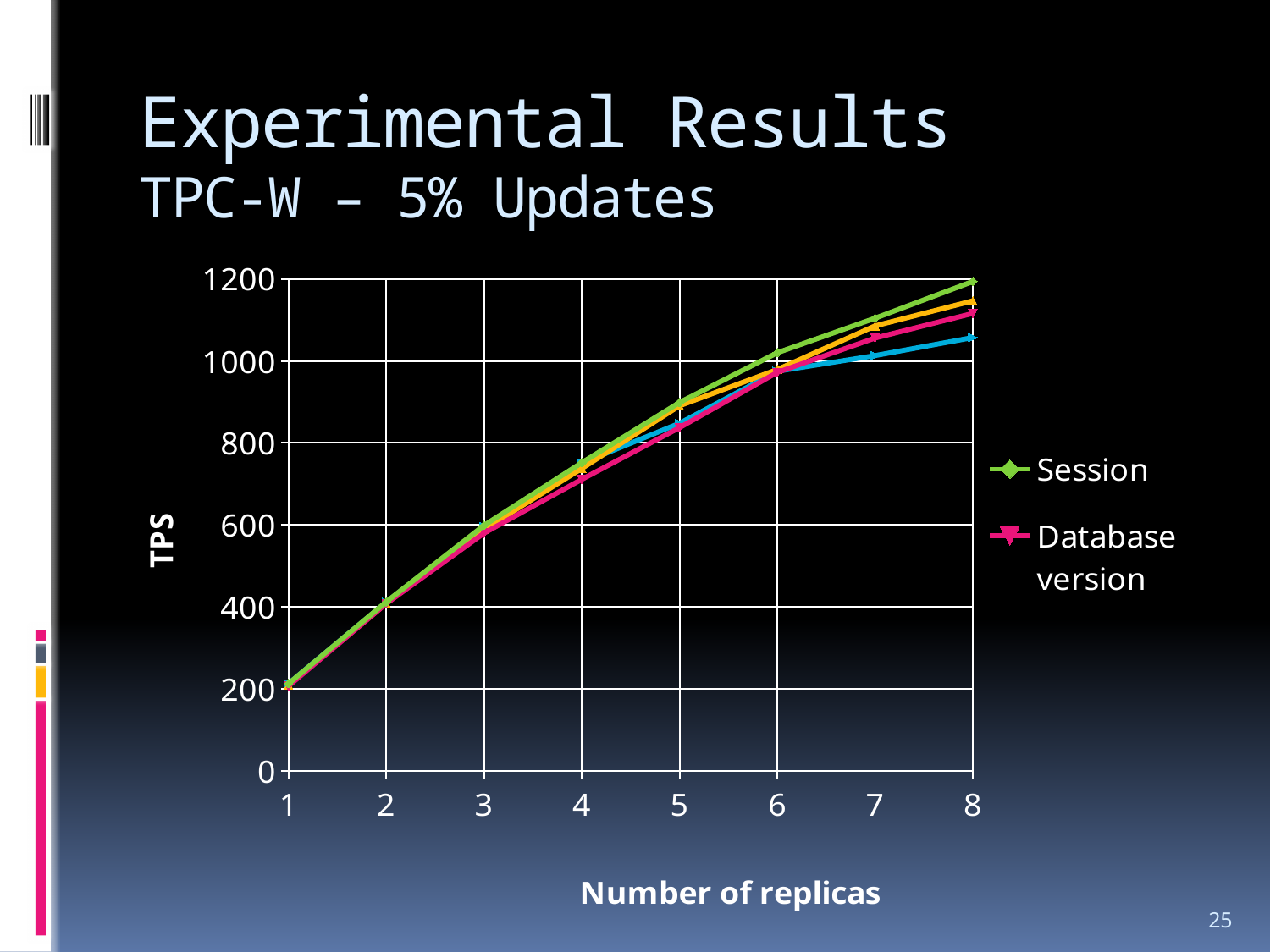
How many series does the legend list? 2 What kind of chart is shown on the slide? line chart How many values of Number of replicas are shown on the x axis? 8 Is the Database version value at 5 replicas greater or less than 900? less Is the Session value at 8 replicas greater or less than 1100? greater Is the Database version value at 8 replicas greater or less than 1000? greater What is the title of the y axis? TPS Does the Session line rise or fall as the number of replicas increases? rises What is the title of the x axis? Number of replicas At 8 replicas, which series has the higher TPS, Session or Database version? Session